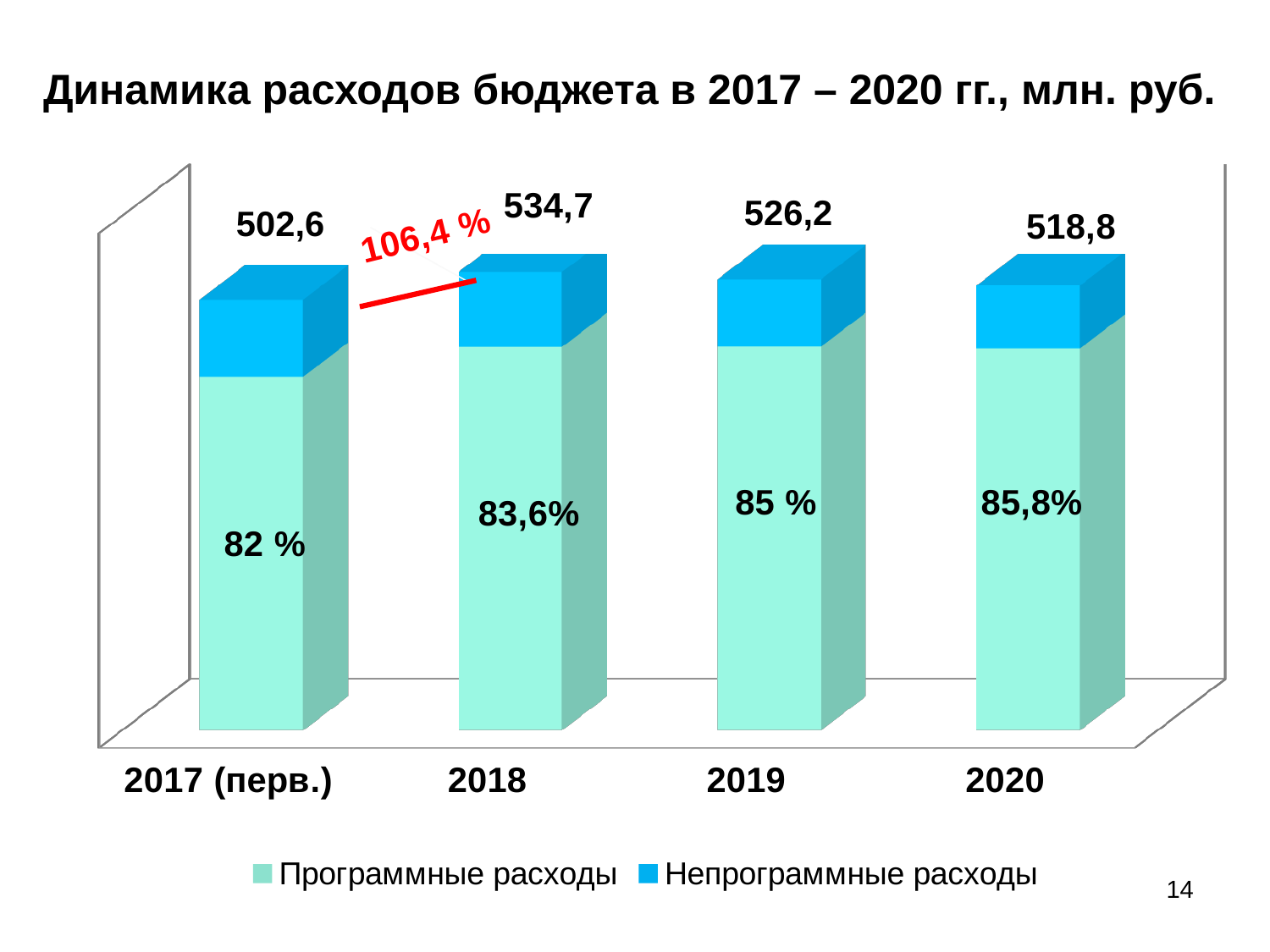
What is the difference between the total expenditure in 2018 and in 2017 (перв.)? 32,1 How many series does the legend list? 2 What kind of chart is shown on the slide? Stacked bar chart Does the share of Программные расходы rise or fall from 2017 (перв.) to 2020? Rises Which is larger, the total expenditure for 2019 or for 2020? 2019 What percentage label is shown on the Программные расходы segment for 2019? 85 % Which year has the lowest total budget expenditure? 2017 (перв.) What is the total budget expenditure shown for 2017 (перв.)? 502,6 What percentage label is shown on the Программные расходы segment for 2020? 85,8% How many years are shown on the x axis? 4 What is the total budget expenditure shown for 2018? 534,7 Which year has the highest total budget expenditure? 2018